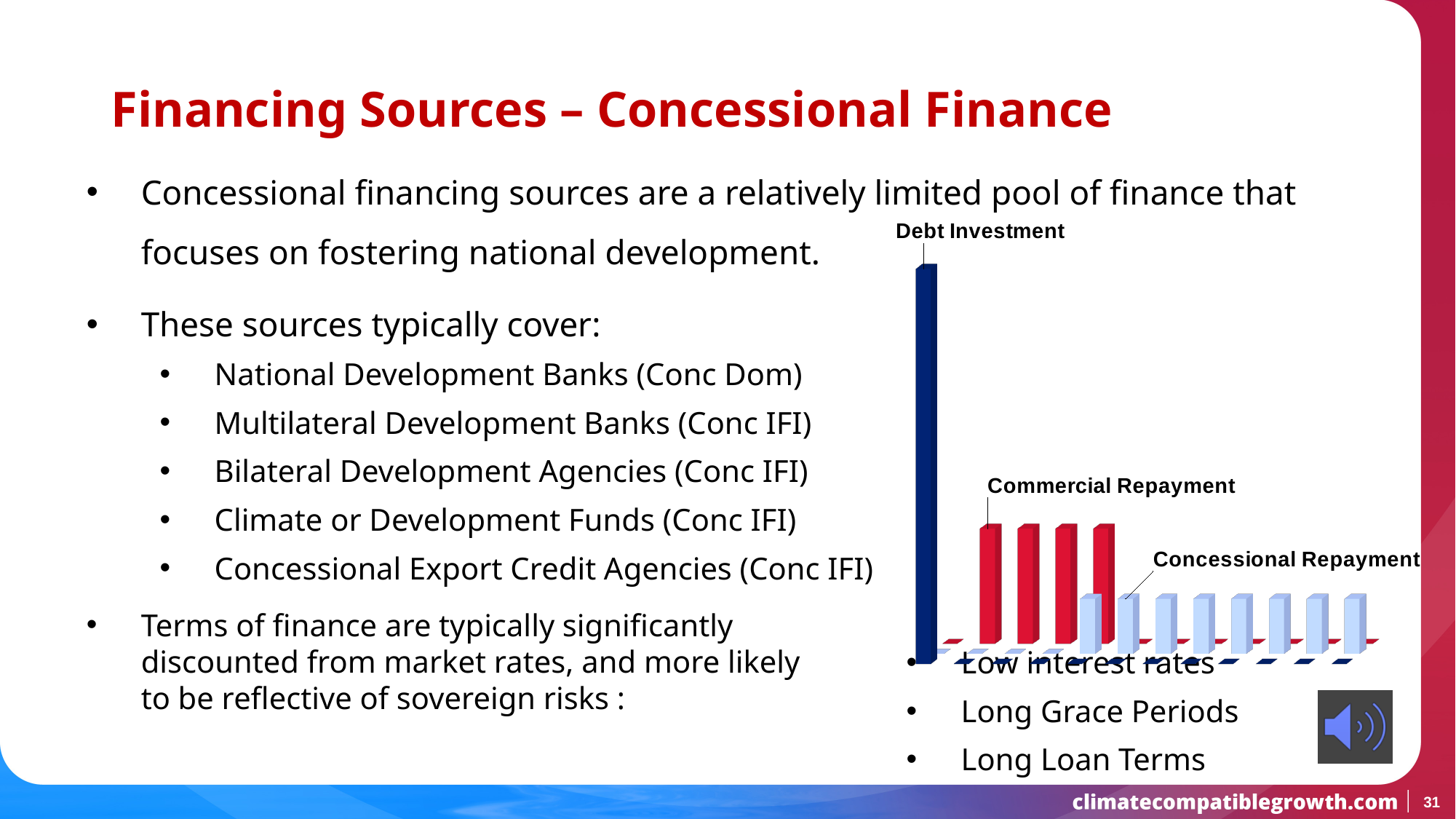
Which is taller in the chart: the Debt Investment bar or a Commercial Repayment bar? Debt Investment What colour are the Commercial Repayment bars in the chart? Red Which is taller in the chart: a Commercial Repayment bar or a Concessional Repayment bar? Commercial Repayment How many Commercial Repayment bars are shown in the chart? 4 Which labelled series has the tallest bar in the chart? Debt Investment What kind of chart is shown on the slide? Bar chart How many Concessional Repayment bars are shown in the chart? 8 Which labelled series has the shortest bars in the chart? Concessional Repayment How many bars are plotted in the chart in total? 13 What colour is the Debt Investment bar in the chart? Dark blue How many labelled series does the chart show? 3